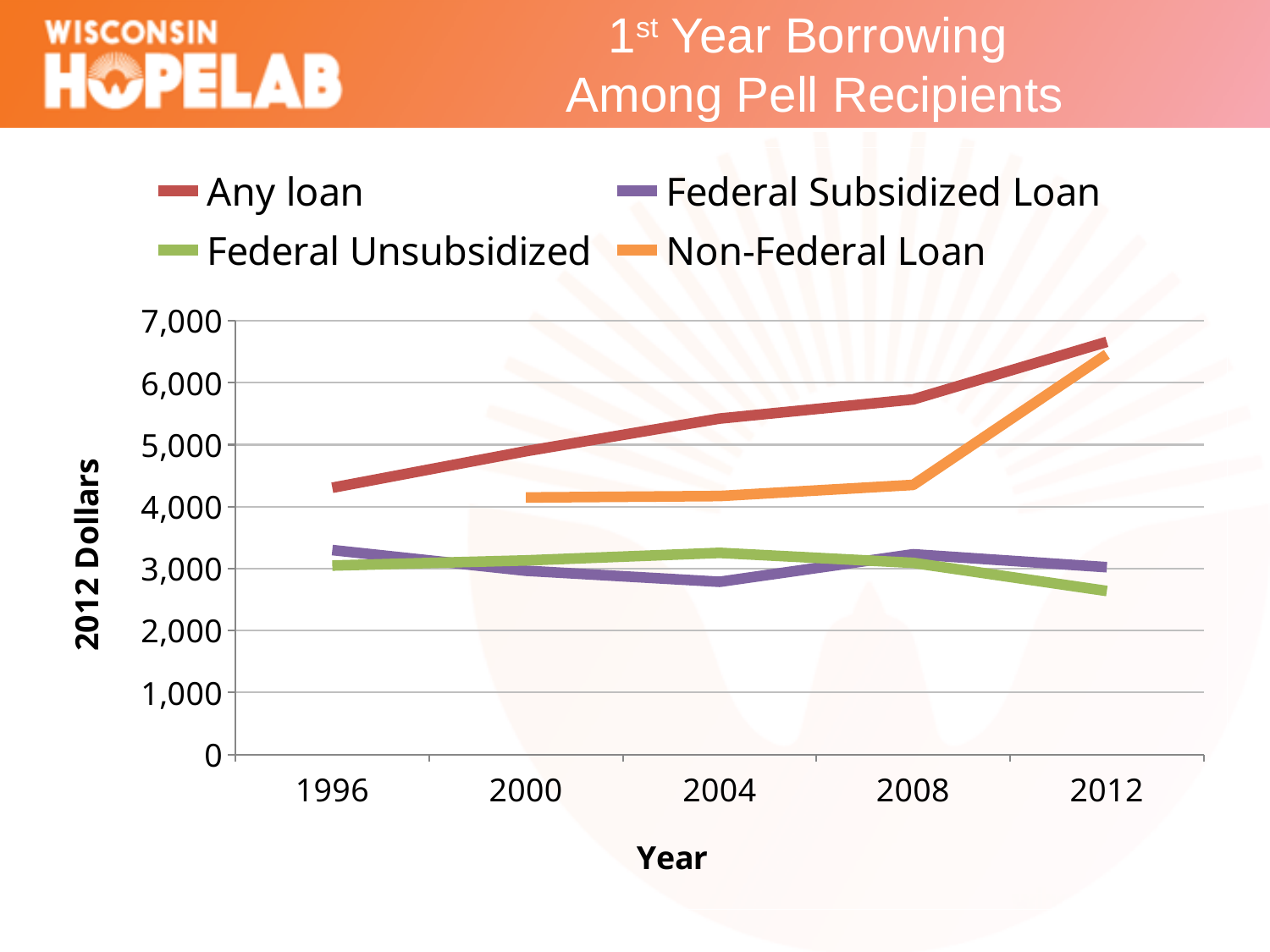
Is the value for Federal Subsidized Loan in 2004 greater or less than 3,000? less What is the title of the y axis? 2012 Dollars In 2004, which is larger: Federal Unsubsidized or Federal Subsidized Loan? Federal Unsubsidized How many series does the legend list? 4 Is the value for Non-Federal Loan in 2008 greater or less than 5,000? less Is the value for Any loan in 2012 greater or less than 6,000? greater What kind of chart is shown on the slide? line chart Does the Any loan series rise or fall from 1996 to 2012? rise Which series has the lowest value in 2012? Federal Unsubsidized In 2012, which is larger: Any loan or Federal Subsidized Loan? Any loan How many years are labelled on the x axis? 5